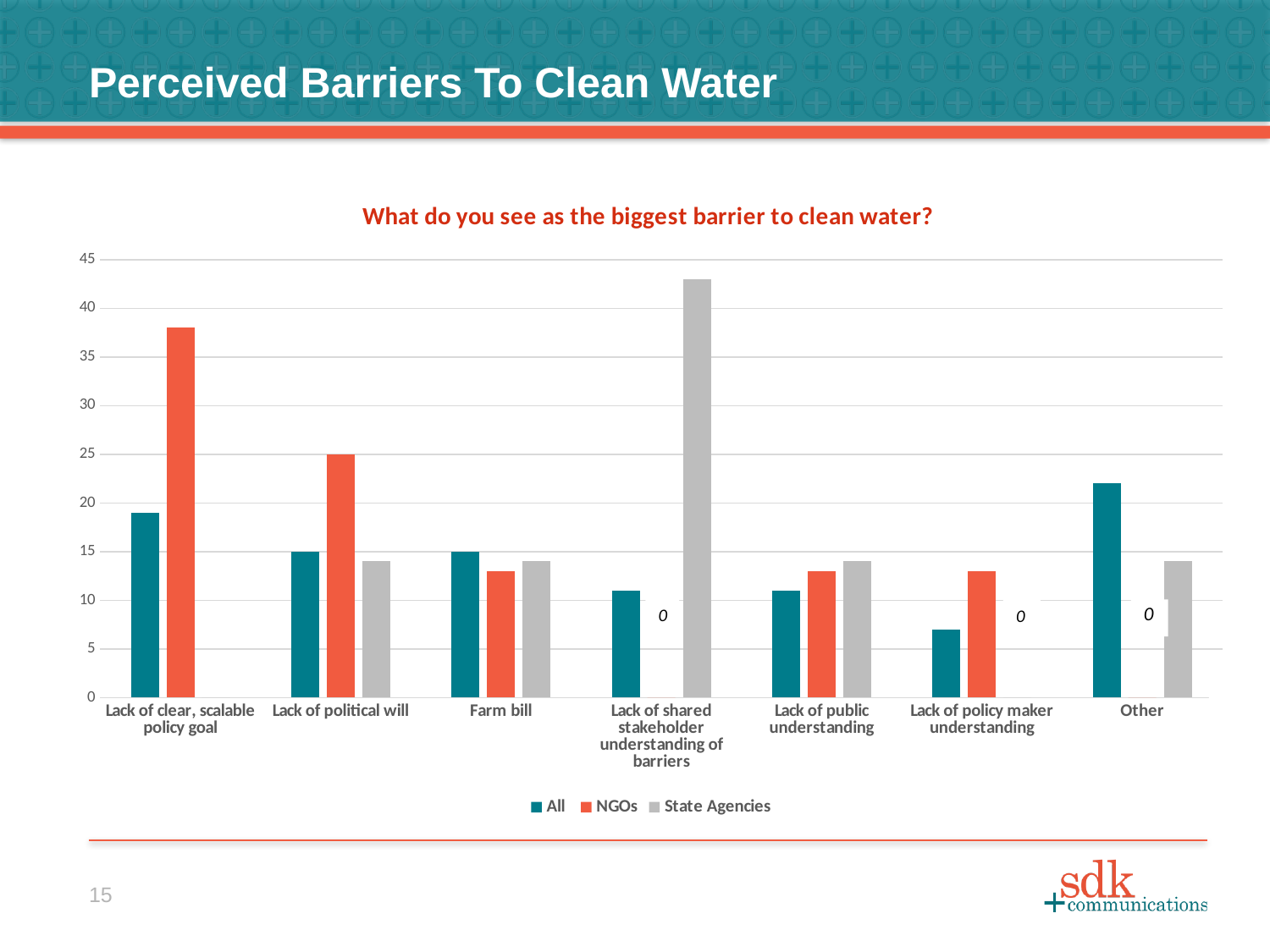
How many barrier categories are shown on the x axis? 7 What is the NGOs value for 'Lack of shared stakeholder understanding of barriers'? 0 What is the NGOs value for 'Other'? 0 Which category has the lowest All bar? Lack of policy maker understanding Which category has the highest State Agencies bar? Lack of shared stakeholder understanding of barriers Which category has the highest NGOs bar? Lack of clear, scalable policy goal Is the NGOs value for 'Lack of clear, scalable policy goal' greater or less than 35? greater How many series does the legend list? 3 What are the three series named in the legend? All, NGOs, State Agencies For 'Lack of clear, scalable policy goal', which is larger: the All bar or the NGOs bar? NGOs What is the State Agencies value for 'Lack of policy maker understanding'? 0 What kind of chart is shown on the slide? bar chart